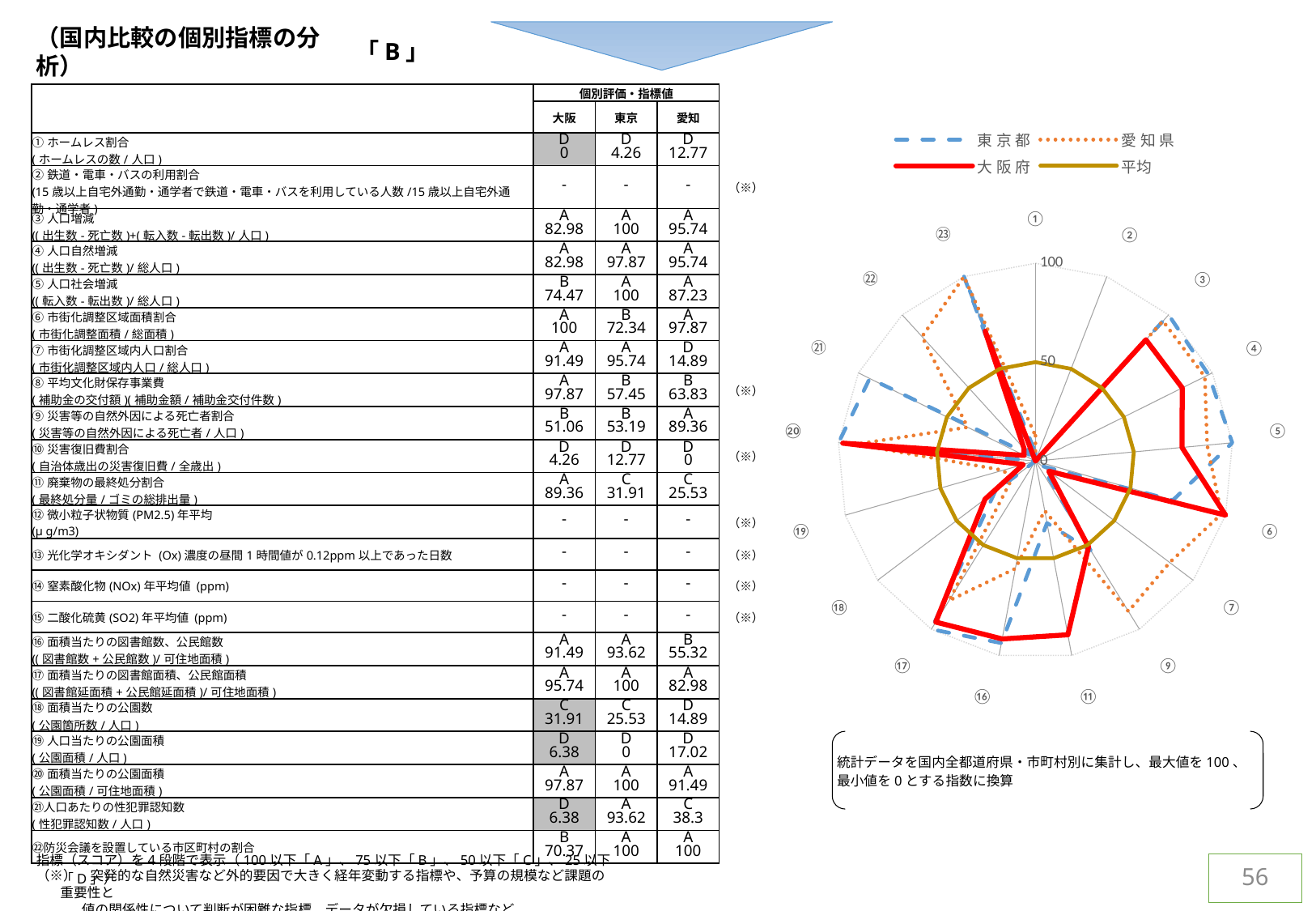
In the radar chart, is the value for 東京都 on axis ⑤ greater or less than 50? greater What kind of chart is shown on the right side of the slide? radar chart In the radar chart, on axis ⑦, which series has the larger value, 大阪府 or 愛知県? 愛知県 In the radar chart, is the value for 大阪府 on axis ① greater or less than 50? less What are the four series listed in the legend of the radar chart? 東京都, 愛知県, 大阪府, 平均 Which series in the radar chart is drawn as a solid red line? 大阪府 In the radar chart, on axis ① which series has the larger value, 大阪府 or 愛知県? 愛知県 In the radar chart, is the value for 大阪府 on axis ⑦ greater or less than 50? less How many series does the legend of the radar chart list? 4